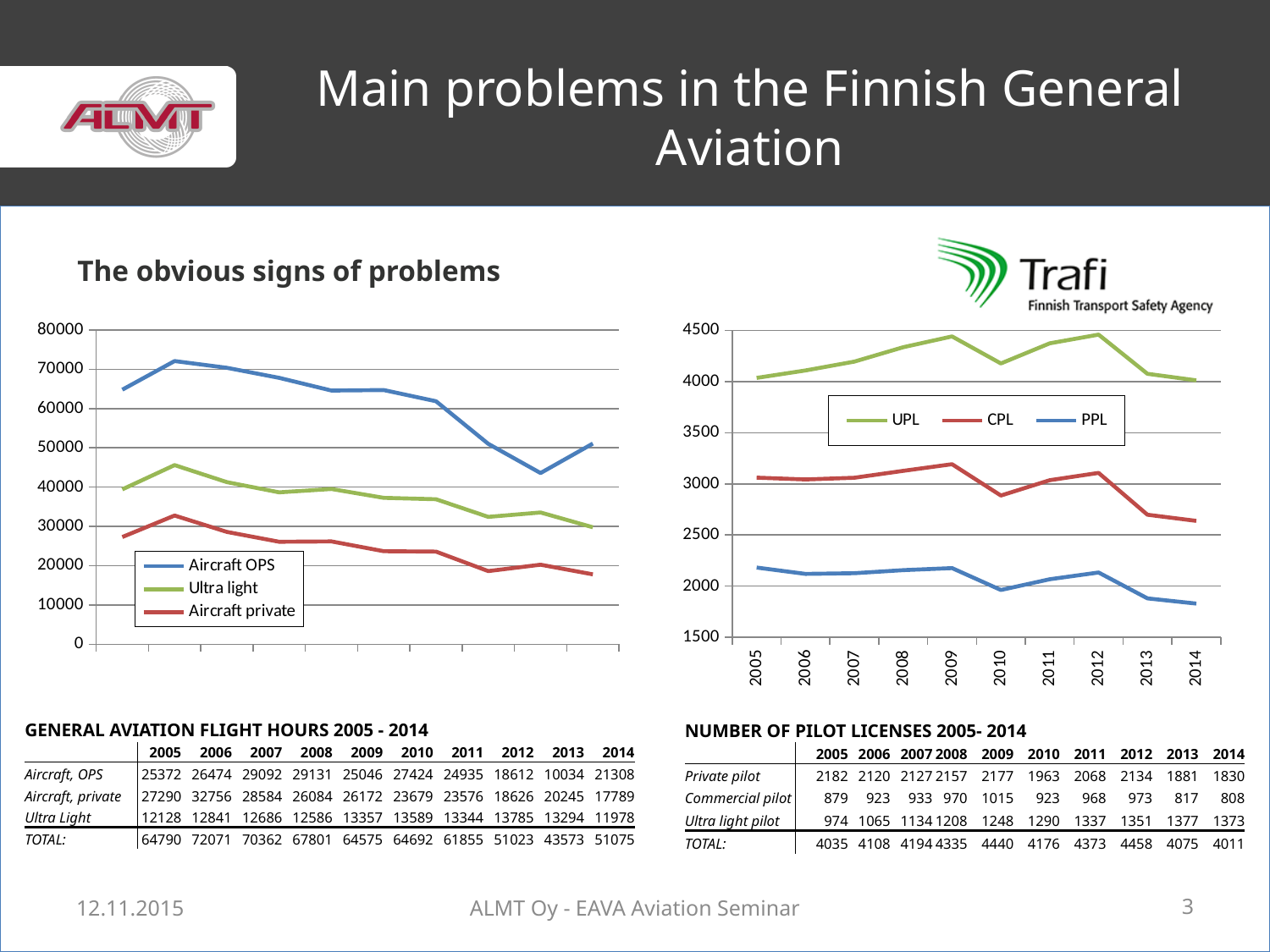
In the left chart, does the Aircraft private line generally rise or fall from left to right? fall How many years are shown on the x axis of the right chart? 10 In the right chart, which is larger in 2010, UPL or PPL? UPL In the right chart, is the UPL value for 2012 greater or less than 4000? greater In the left chart, is the peak value of the Aircraft OPS line greater or less than 70000? greater In the right chart, is the PPL value for 2014 greater or less than 2000? less How many series does the legend of the left chart list? 3 What kind of chart is the left chart under 'The obvious signs of problems'? line chart How many series does the legend of the right chart (UPL, CPL, PPL) list? 3 In the right chart, which year has the highest CPL value? 2009